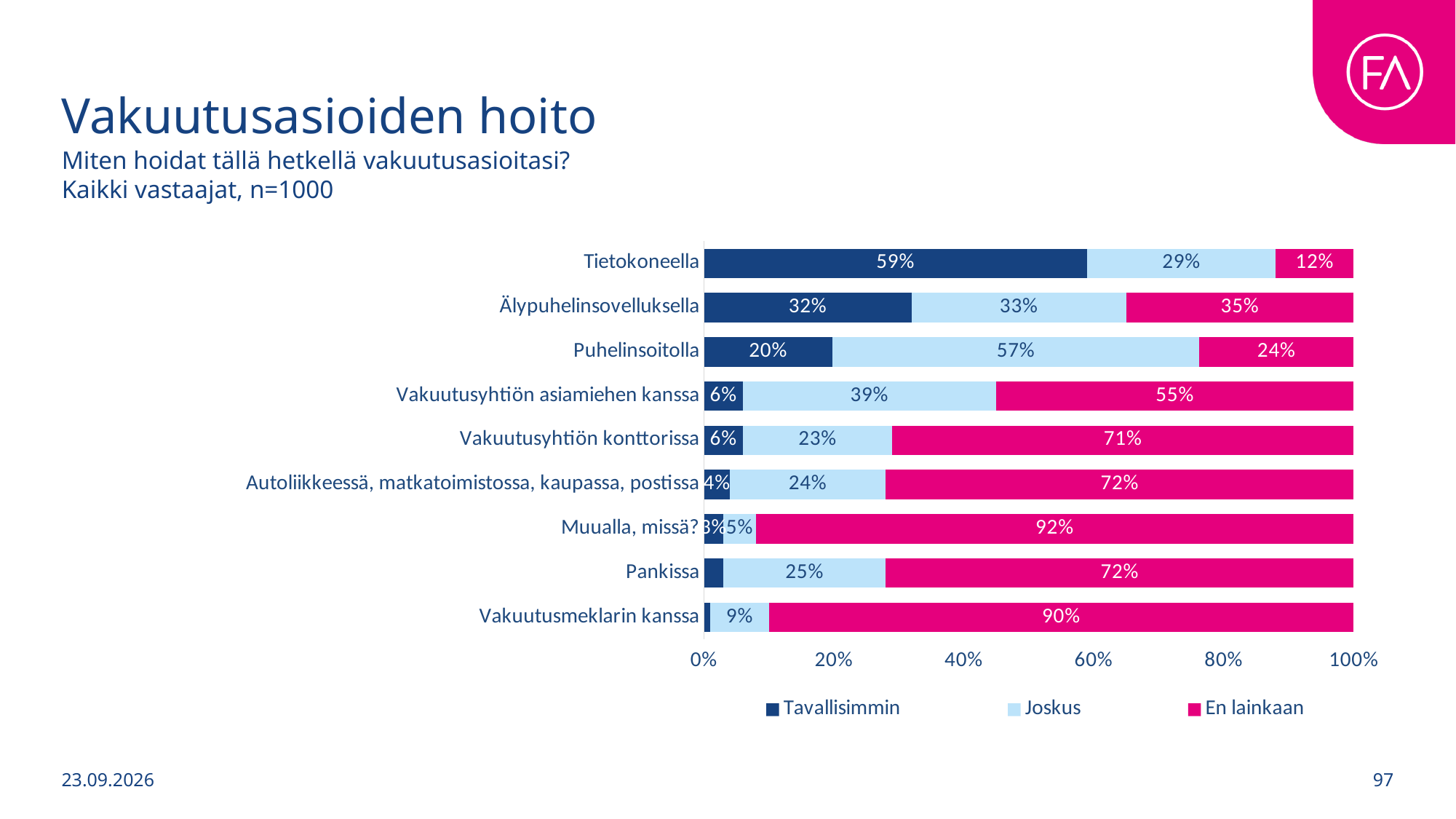
What is the "Joskus" value for Puhelinsoitolla? 57% Which is larger: the "Joskus" value for Älypuhelinsovelluksella or the "Joskus" value for Tietokoneella? Älypuhelinsovelluksella How many series does the legend list? 3 Which category has the lowest "En lainkaan" value? Tietokoneella What is the "En lainkaan" value for Vakuutusyhtiön konttorissa? 71% How many categories are shown on the chart? 9 Which legend entry is shown in pink? En lainkaan Which category has the highest "Tavallisimmin" value? Tietokoneella What is the difference between the "En lainkaan" values for Vakuutusmeklarin kanssa and Vakuutusyhtiön asiamiehen kanssa? 35% What kind of chart is shown on the slide? Stacked bar chart What percentage of respondents answered "Tavallisimmin" for Tietokoneella? 59% Which category has the highest "En lainkaan" value? Muualla, missä?